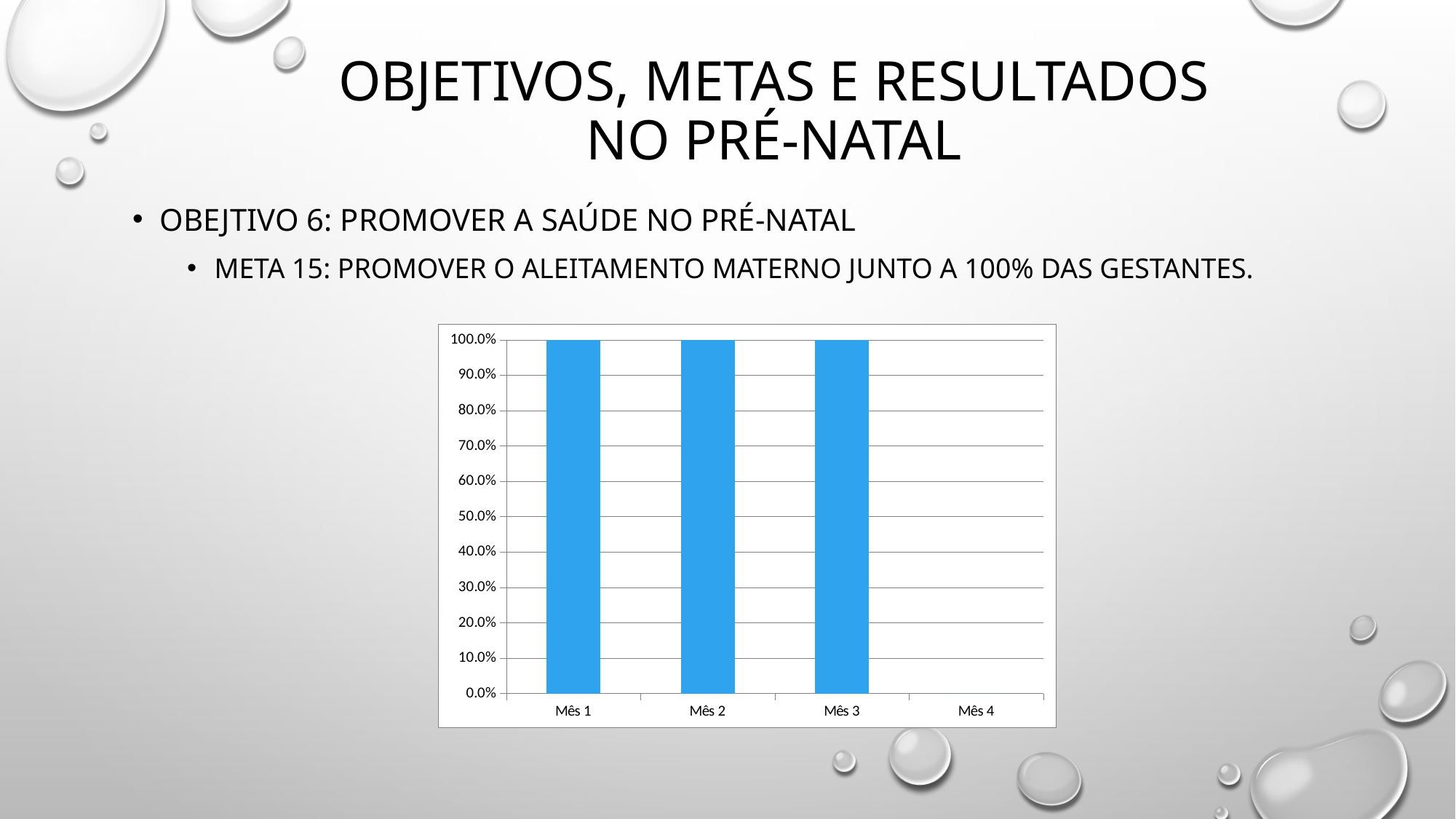
What is the value for Mês 2? 100.0% Is the value for Mês 3 greater or less than 90.0%? greater Which category has the lowest value in the chart? Mês 4 What is the value for Mês 1? 100.0% Which category has no visible bar in the chart? Mês 4 What kind of chart is shown on the slide? bar chart How many categories are shown on the x axis of the chart? 4 What is the value for Mês 3? 100.0% What is the difference between the values for Mês 1 and Mês 2? 0.0% Is the value for Mês 1 greater or less than 50.0%? greater Is the value for Mês 2 larger than the value for Mês 4? Yes What is the highest value shown on the y axis of the chart? 100.0%